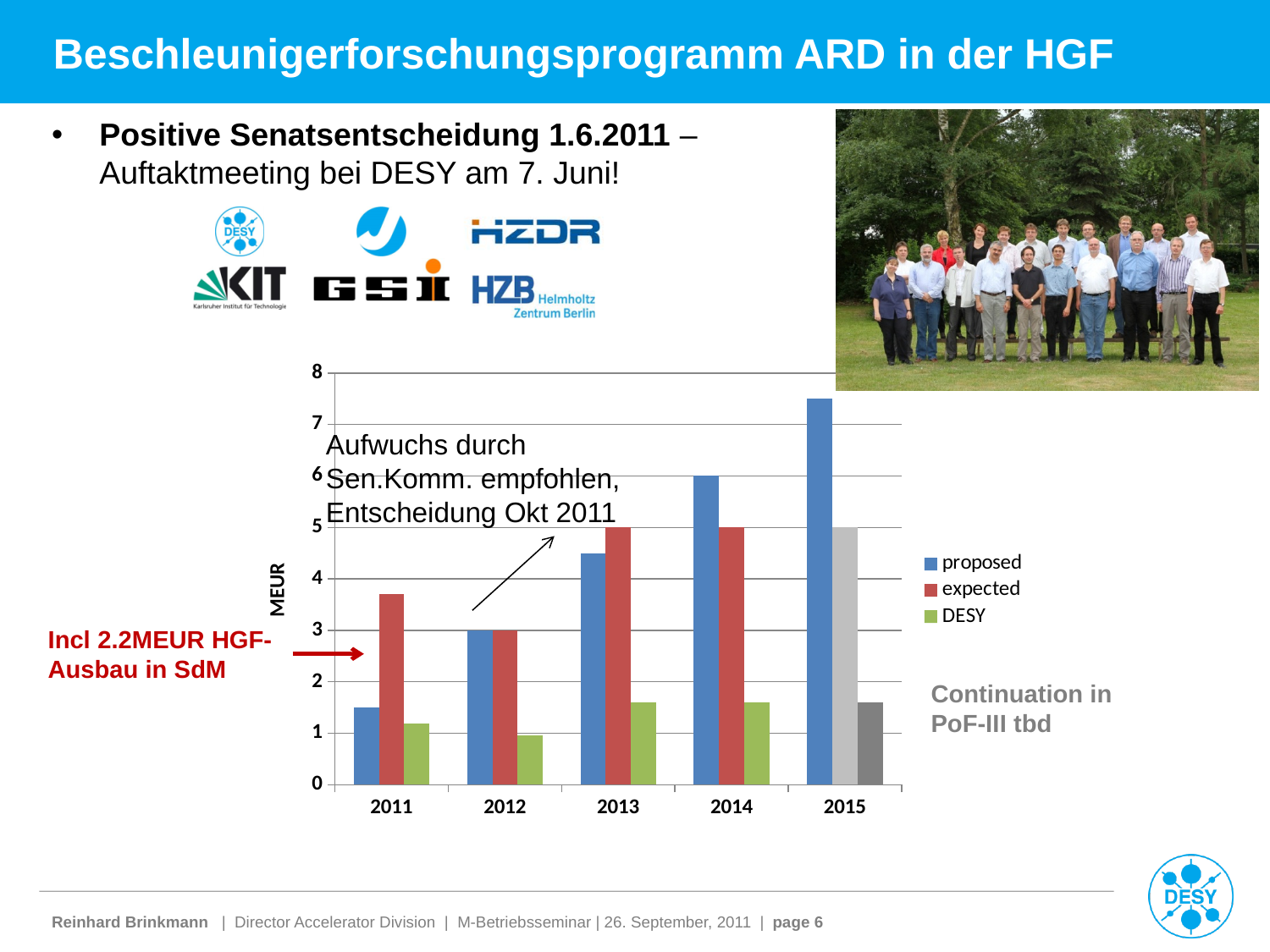
In which year is the proposed value highest? 2015 What is the label on the y axis of the chart? MEUR Is the proposed value for 2015 greater or less than 7? greater In which year is the DESY value lowest? 2012 Do the proposed values rise or fall from 2011 to 2015? rise For 2011, which is larger: the proposed value or the expected value? expected How many series does the chart legend list? 3 For 2014, which is larger: the proposed value or the expected value? proposed Is the proposed value for 2011 greater or less than 2? less How many years are shown on the x axis of the chart? 5 Is the expected value for 2011 greater or less than 3? greater What kind of chart is shown on the slide? bar chart